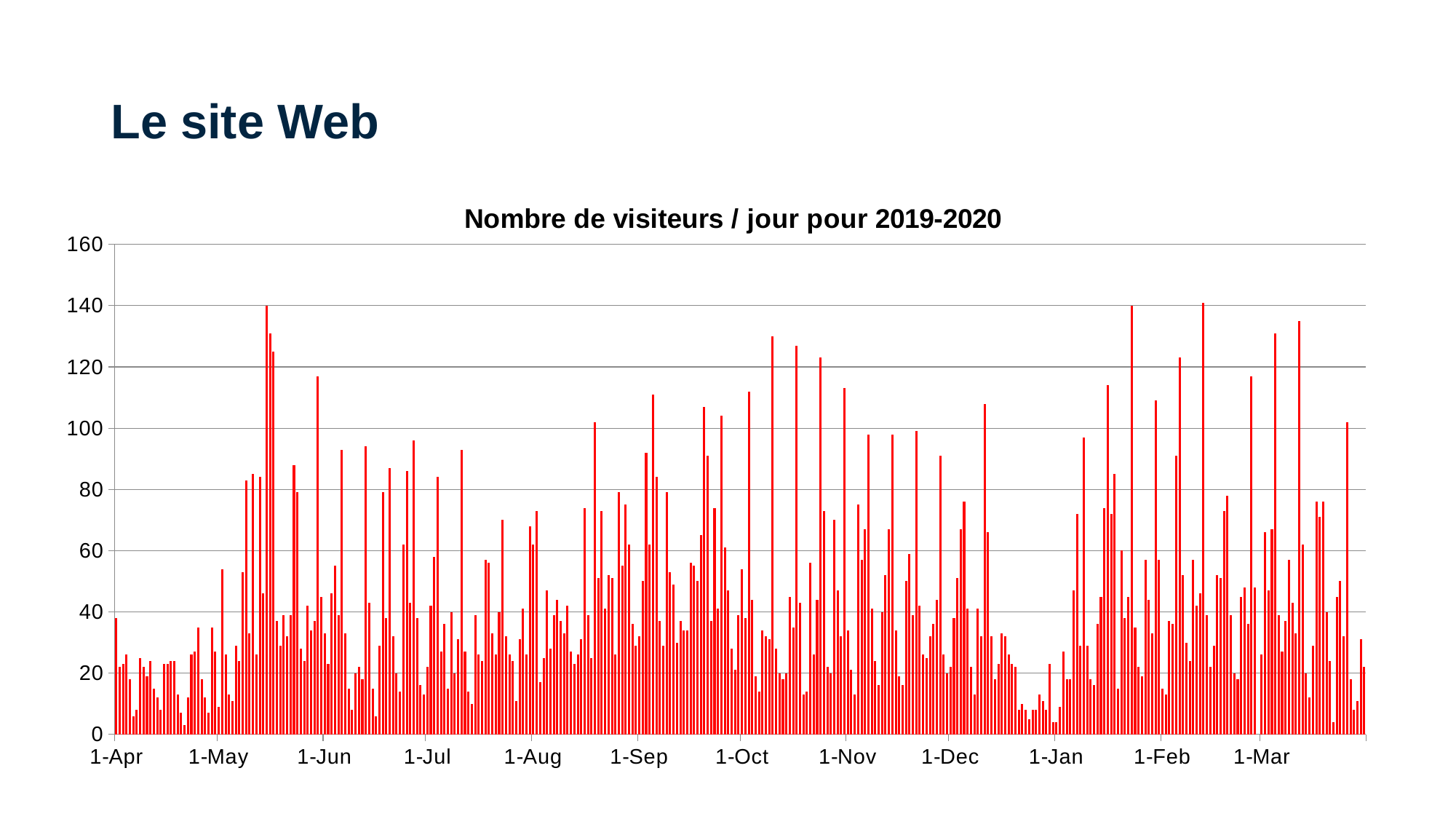
How many month labels are shown on the x axis? 12 What colour are the bars in the chart? red What is the highest value shown on the y axis? 160 What is the interval between consecutive tick marks on the y axis? 20 What is the last label on the x axis? 1-Mar Is the highest daily visitor value in the chart greater or less than 160? less What is the first label on the x axis? 1-Apr Is the highest daily visitor value in the chart greater or less than 120? greater What is the title of the chart? Nombre de visiteurs / jour pour 2019-2020 Is the value for 1-Apr greater or less than 20? greater What kind of chart is shown on the slide? bar chart